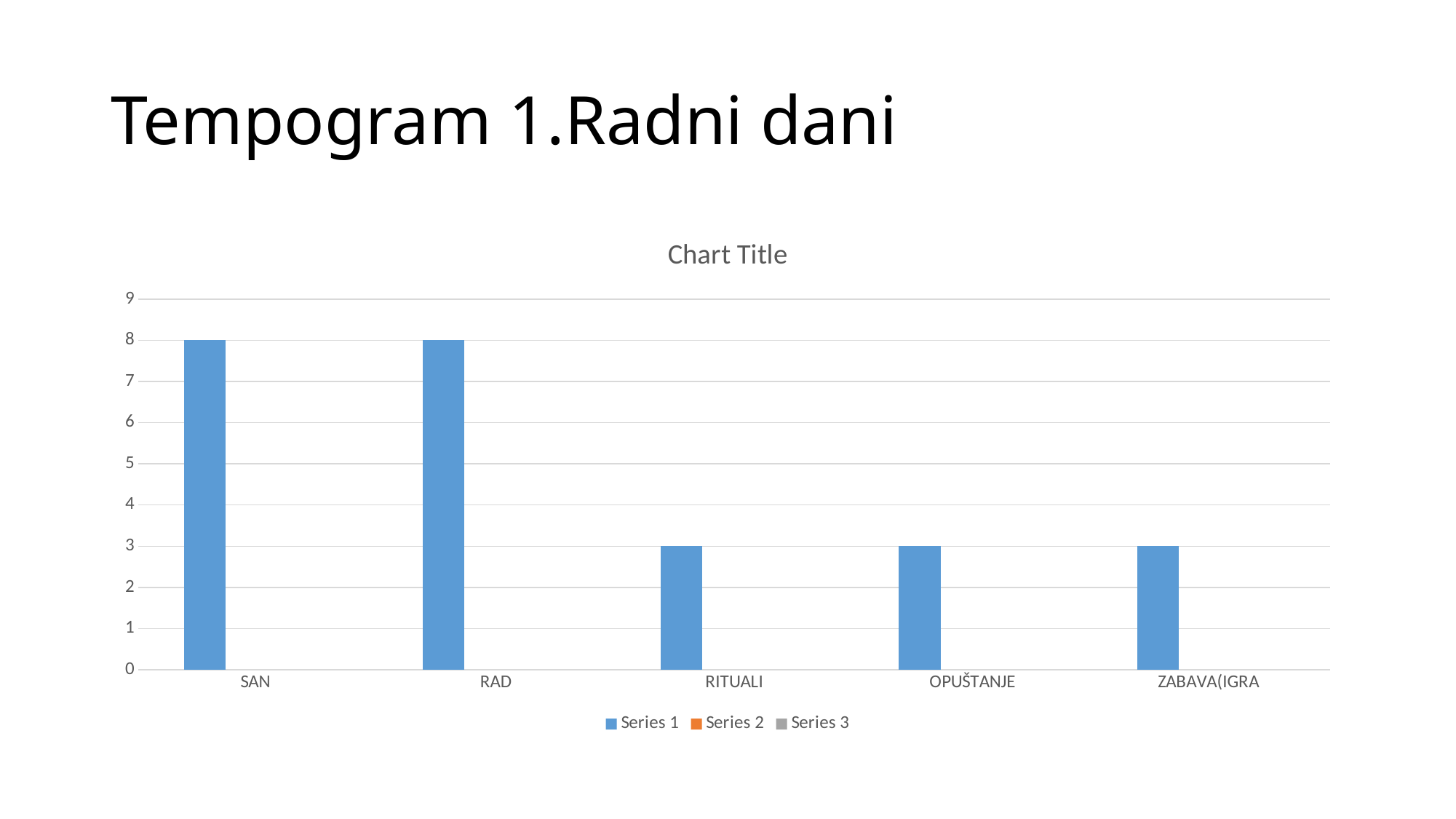
Is the value for ZABAVA(IGRA greater or less than 5? less How many categories are shown on the x axis? 5 What is the value for RITUALI? 3 What is the value for OPUŠTANJE? 3 Which is larger, the value for RAD or the value for OPUŠTANJE? RAD What kind of chart is shown on the slide? bar chart What is the difference between the values for SAN and RITUALI? 5 What is the value for RAD? 8 What is the value for SAN? 8 How many series does the legend list? 3 What is the title shown above the chart? Chart Title What is the value for ZABAVA(IGRA? 3